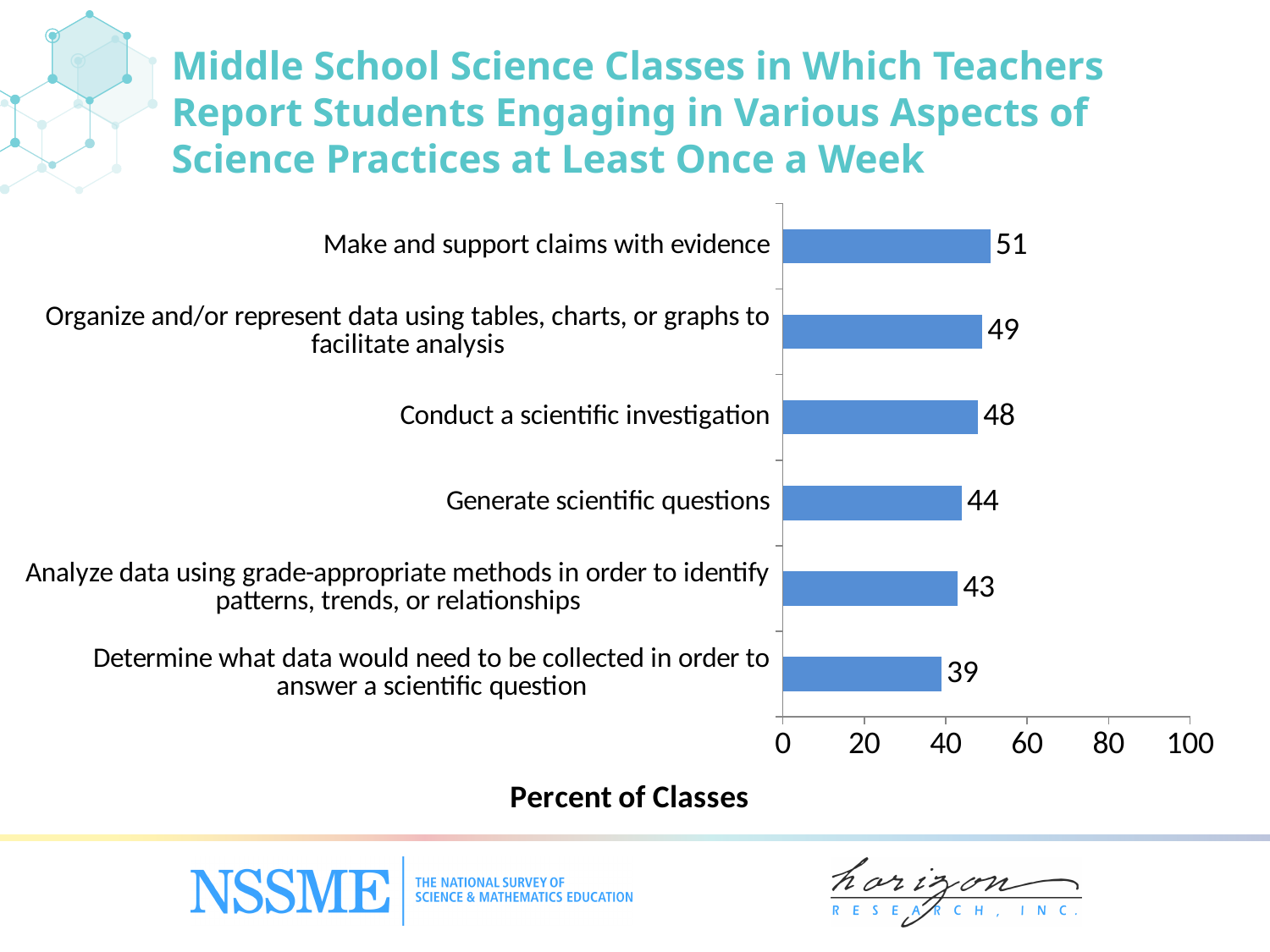
Is the value for "Organize and/or represent data using tables, charts, or graphs to facilitate analysis" greater or less than 40? greater Which is larger: the value for "Conduct a scientific investigation" or the value for "Analyze data using grade-appropriate methods in order to identify patterns, trends, or relationships"? Conduct a scientific investigation What percent of classes is reported for "Make and support claims with evidence"? 51 What is the difference between the values for "Make and support claims with evidence" and "Conduct a scientific investigation"? 3 What is the value for "Generate scientific questions"? 44 What is the difference between the values for "Generate scientific questions" and "Determine what data would need to be collected in order to answer a scientific question"? 5 Which category has the lowest value? Determine what data would need to be collected in order to answer a scientific question Which category has the highest value? Make and support claims with evidence What kind of chart is shown on the slide? Bar chart What is the label of the horizontal axis? Percent of Classes How many categories are shown in the chart? 6 What percent of classes is shown for "Determine what data would need to be collected in order to answer a scientific question"? 39